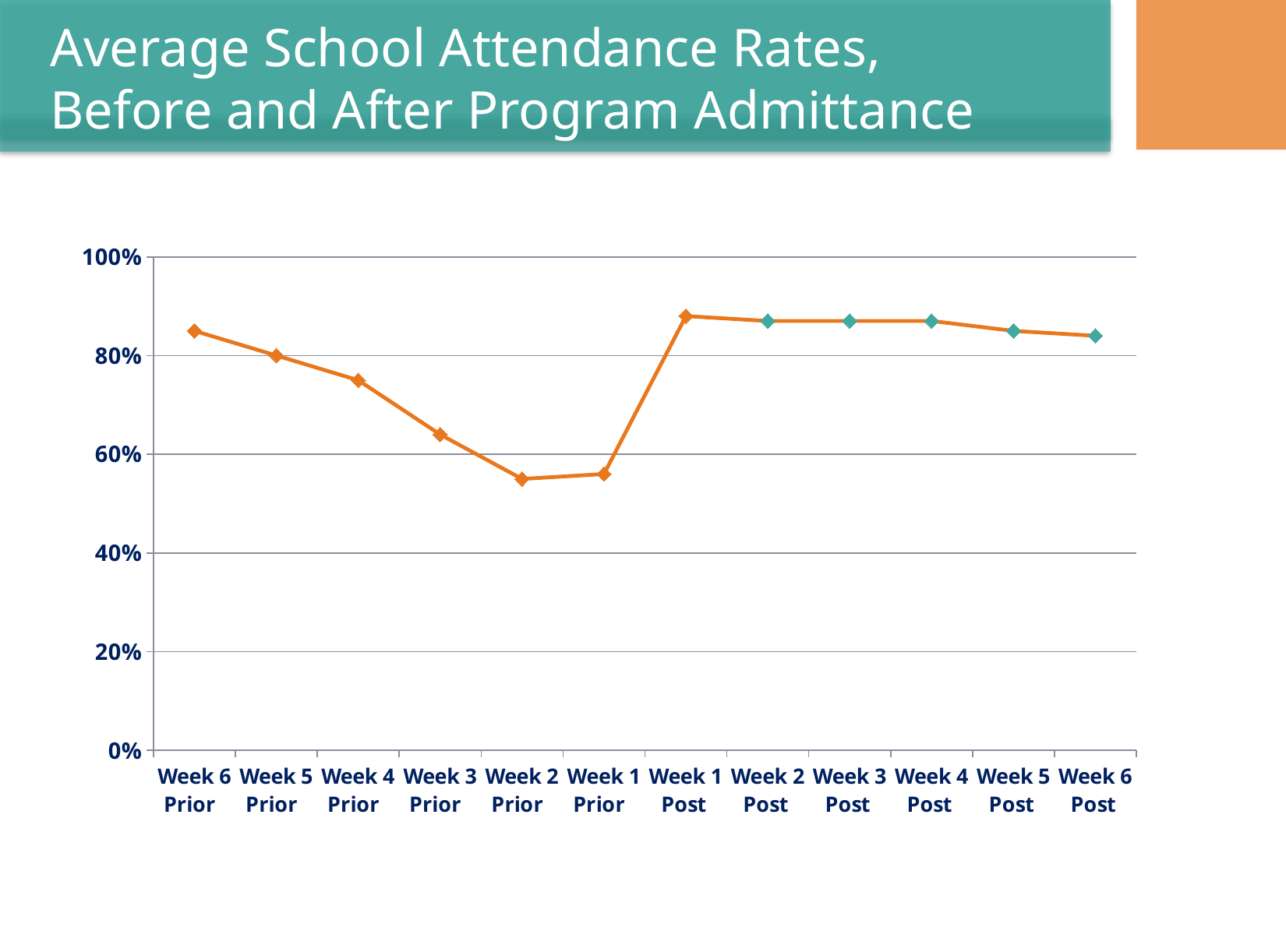
What is the title of the slide containing the chart? Average School Attendance Rates, Before and After Program Admittance Is the value for Week 1 Post greater or less than 80%? greater Is the value for Week 4 Prior greater or less than 80%? less Is the value for Week 3 Prior greater or less than 60%? greater How many data points are plotted on the chart? 12 Which is larger, the value for Week 6 Prior or the value for Week 3 Prior? Week 6 Prior What is the lowest value shown on the vertical axis? 0% Which is larger, the value for Week 1 Prior or the value for Week 1 Post? Week 1 Post Do the values rise or fall from Week 6 Prior to Week 2 Prior? fall What kind of chart is shown on the slide? line chart